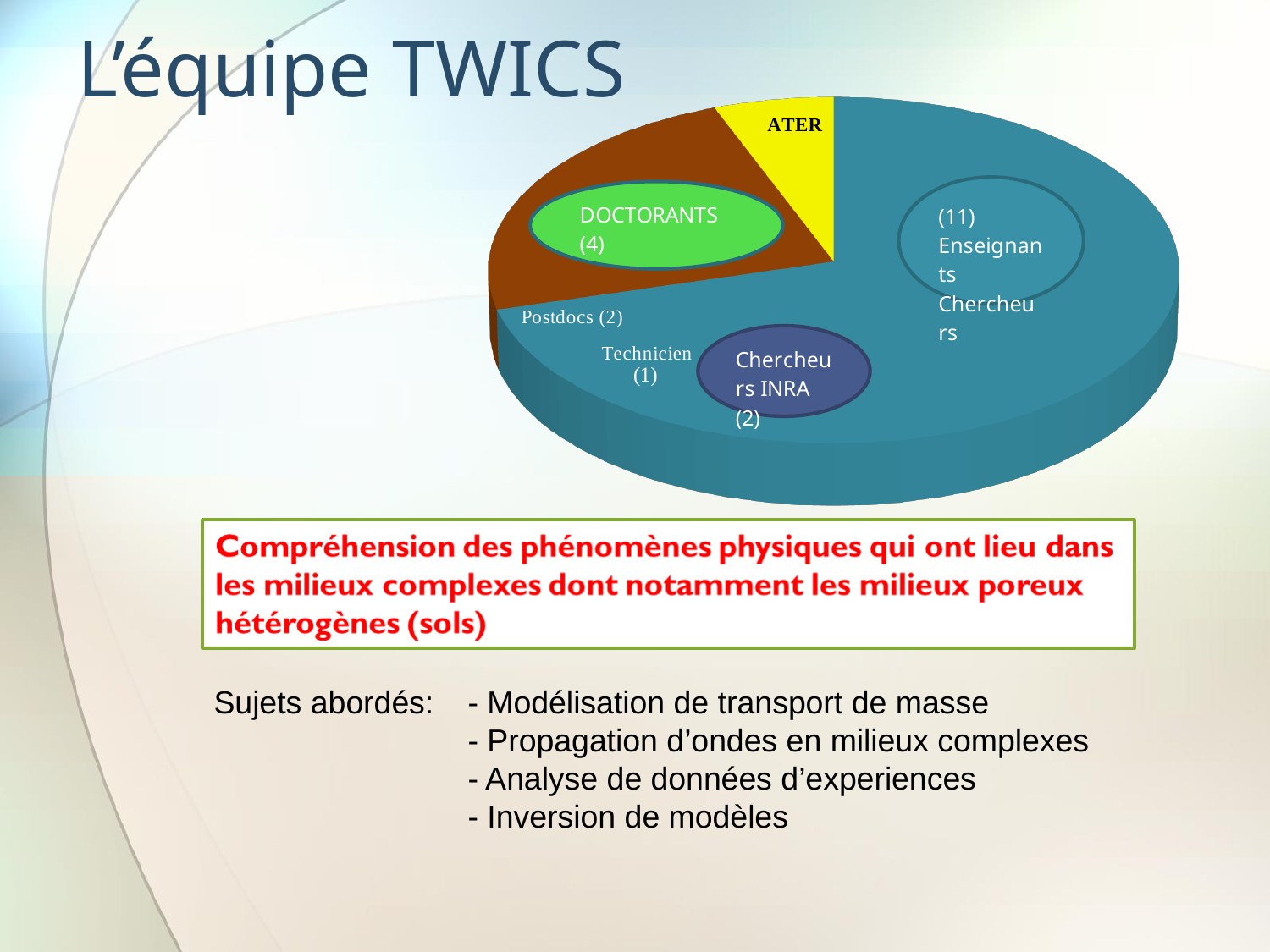
What is the difference between the number of Enseignants Chercheurs and the number of Doctorants? 7 How many Chercheurs INRA are shown in the pie chart? 2 Which is larger, the number of Doctorants or the number of Postdocs? Doctorants What is the title of the slide containing the pie chart? L'équipe TWICS What is the number shown for Enseignants Chercheurs in the pie chart? 11 Which is larger, the number of Enseignants Chercheurs or the number of Chercheurs INRA? Enseignants Chercheurs How many Postdocs are shown in the pie chart? 2 What is the number shown for Technicien in the pie chart? 1 How many Doctorants are shown in the pie chart? 4 What kind of chart is shown on the slide? pie chart What colour is the ATER slice in the pie chart? yellow Which category has the largest slice in the pie chart? Enseignants Chercheurs